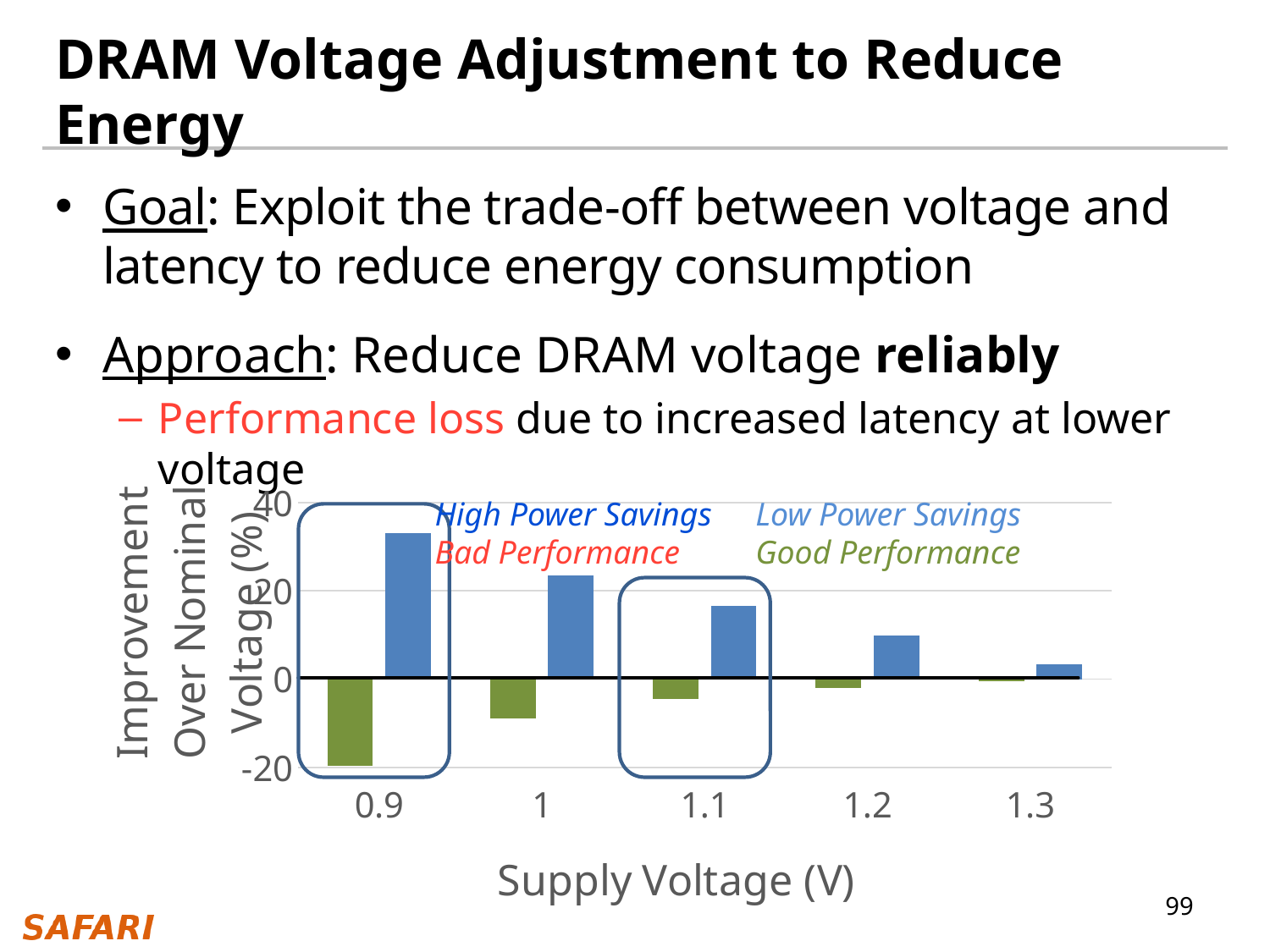
Is the green bar at 0.9 V greater or less than 0? less Do the blue bars rise or fall as supply voltage increases from 0.9 to 1.3 V? fall Is the blue bar at 1.2 V greater or less than 20? less At which supply voltage is the green bar lowest? 0.9 Is the blue bar at 0.9 V greater or less than 20? greater At which supply voltage is the blue bar highest? 0.9 What is the title of the x axis? Supply Voltage (V) How many supply voltage categories are shown on the x axis? 5 What is the title of the y axis? Improvement Over Nominal Voltage (%) What kind of chart is shown on the slide? bar chart Which is larger, the blue bar at 1 V or the blue bar at 1.2 V? 1 V